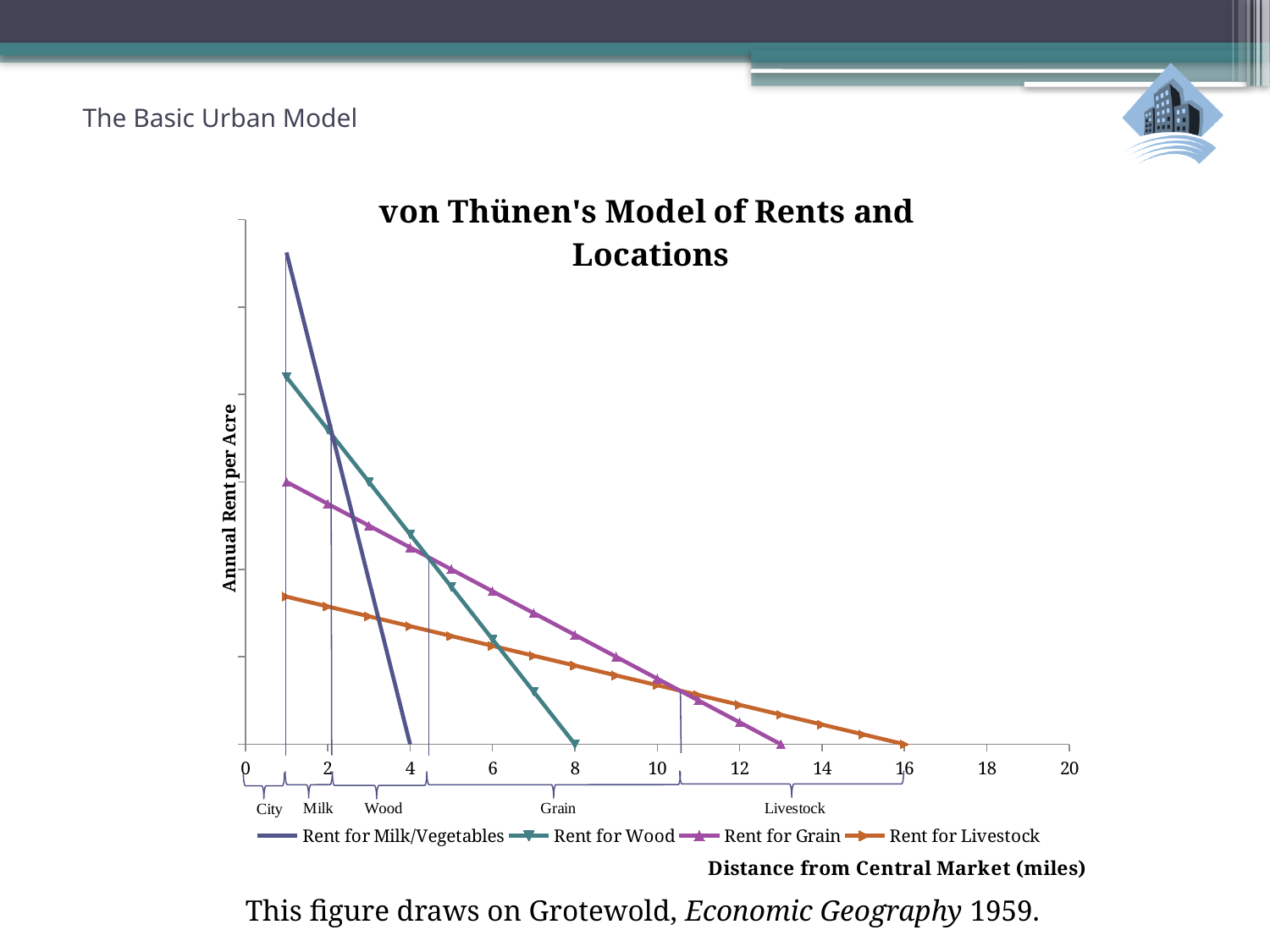
Which series has the lowest rent at the point nearest the central market? Rent for Livestock At what distance from the central market does Rent for Wood fall to zero? 8 At what distance from the central market does Rent for Livestock fall to zero? 16 What is the label of the x axis? Distance from Central Market (miles) At what distance from the central market does Rent for Grain fall to zero? 13 Which series has the highest rent at the point nearest the central market? Rent for Milk/Vegetables What kind of chart is shown on the slide? line chart Which series extends farthest from the central market before reaching zero? Rent for Livestock Do the rent values rise or fall as distance from the central market increases? fall At what distance from the central market does Rent for Milk/Vegetables fall to zero? 4 What is the title of the chart? von Thünen's Model of Rents and Locations How many series does the legend list? 4